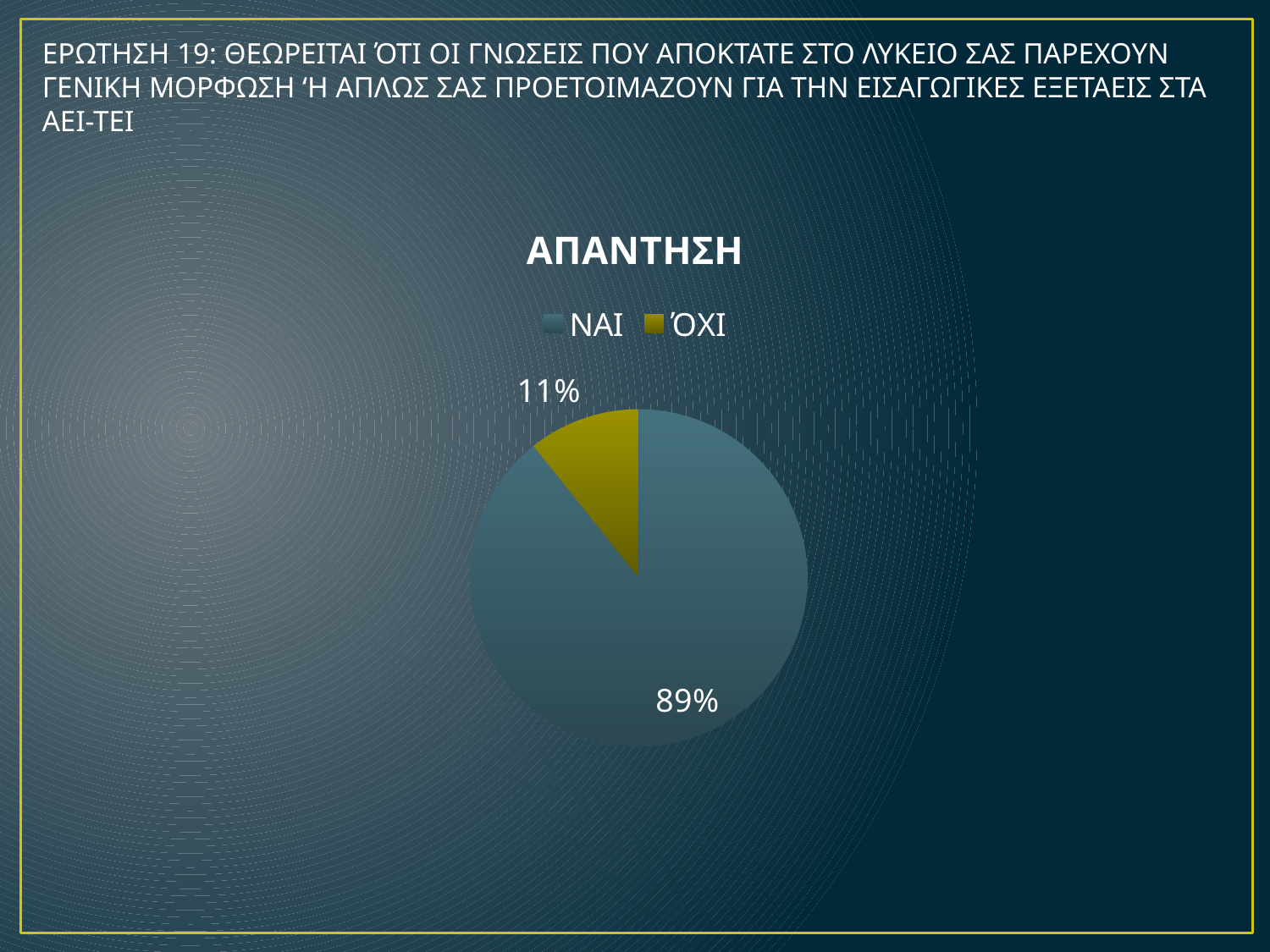
Which category has the largest slice of the pie? ΝΑΙ What is the title of the chart? ΑΠΑΝΤΗΣΗ Which category has the smallest slice of the pie? ΌΧΙ What share of the pie does ΌΧΙ take? 11% How many entries does the legend list? 2 What kind of chart is shown on the slide? pie chart What is the difference in percentage points between the ΝΑΙ and ΌΧΙ slices? 78 What share of the pie does ΝΑΙ take? 89% Which legend entry is shown in yellow? ΌΧΙ How many categories does the pie chart show? 2 Which is larger, the ΝΑΙ slice or the ΌΧΙ slice? ΝΑΙ